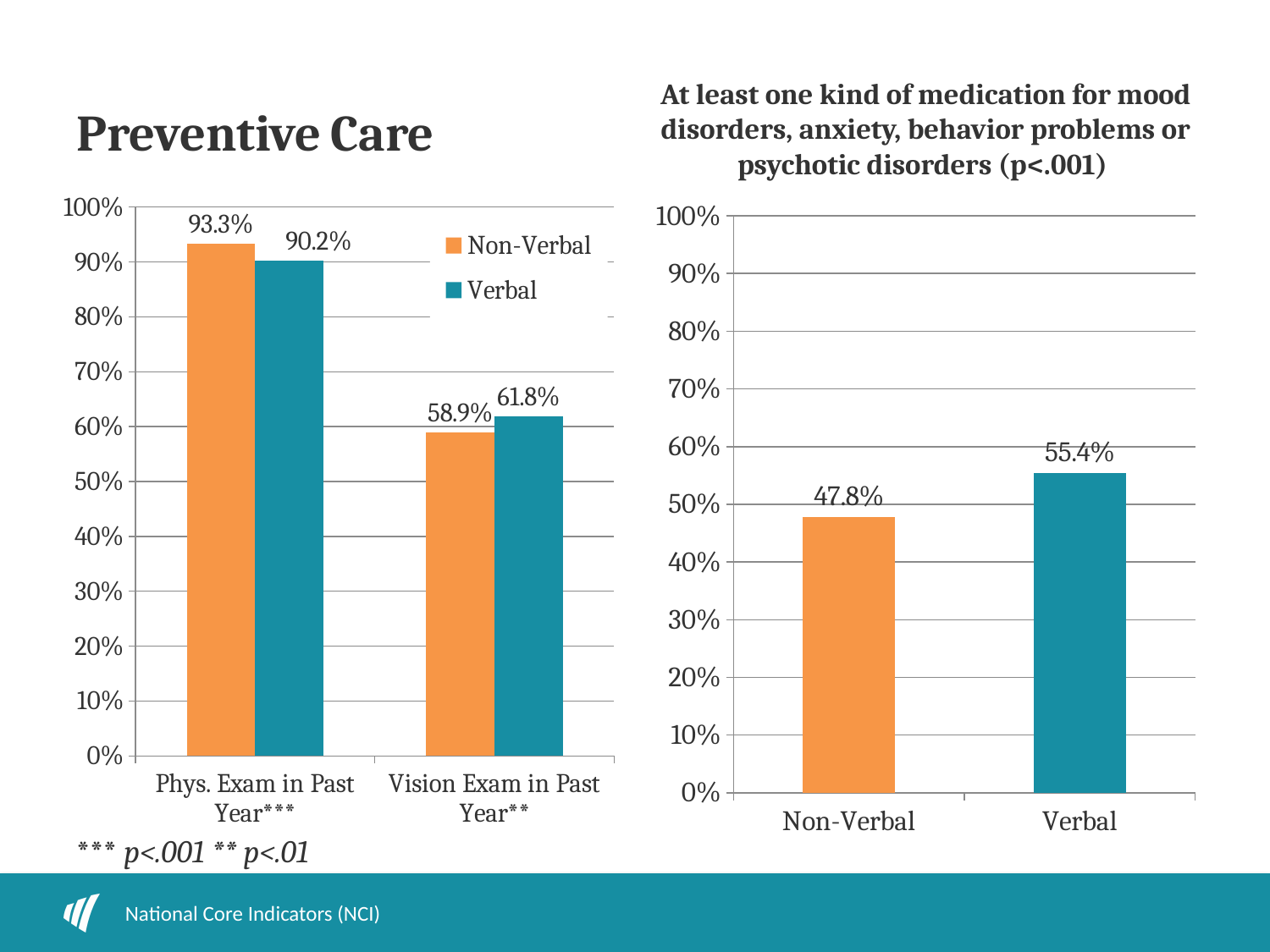
In the Preventive Care chart, what is the difference between the Non-Verbal and Verbal values for Phys. Exam in Past Year? 3.1% In the chart on the right (medication for mood disorders), which category has the highest value? Verbal In the Preventive Care chart, how many categories are shown on the x axis? 2 What kind of chart is the chart on the right (medication for mood disorders)? Bar chart In the chart on the right (medication for mood disorders), what is the value for Verbal? 55.4% In the Preventive Care chart, what is the Verbal value for Vision Exam in Past Year? 61.8% In the Preventive Care chart, how many series does the legend list? 2 In the Preventive Care chart, what is the Non-Verbal value for Phys. Exam in Past Year? 93.3% In the chart on the right (medication for mood disorders), what is the value for Non-Verbal? 47.8% In the Preventive Care chart, which group has the higher value for Vision Exam in Past Year, Non-Verbal or Verbal? Verbal In the chart on the right (medication for mood disorders), what is the difference between the Verbal and Non-Verbal values? 7.6% In the Preventive Care chart, which colour represents the Non-Verbal series? Orange